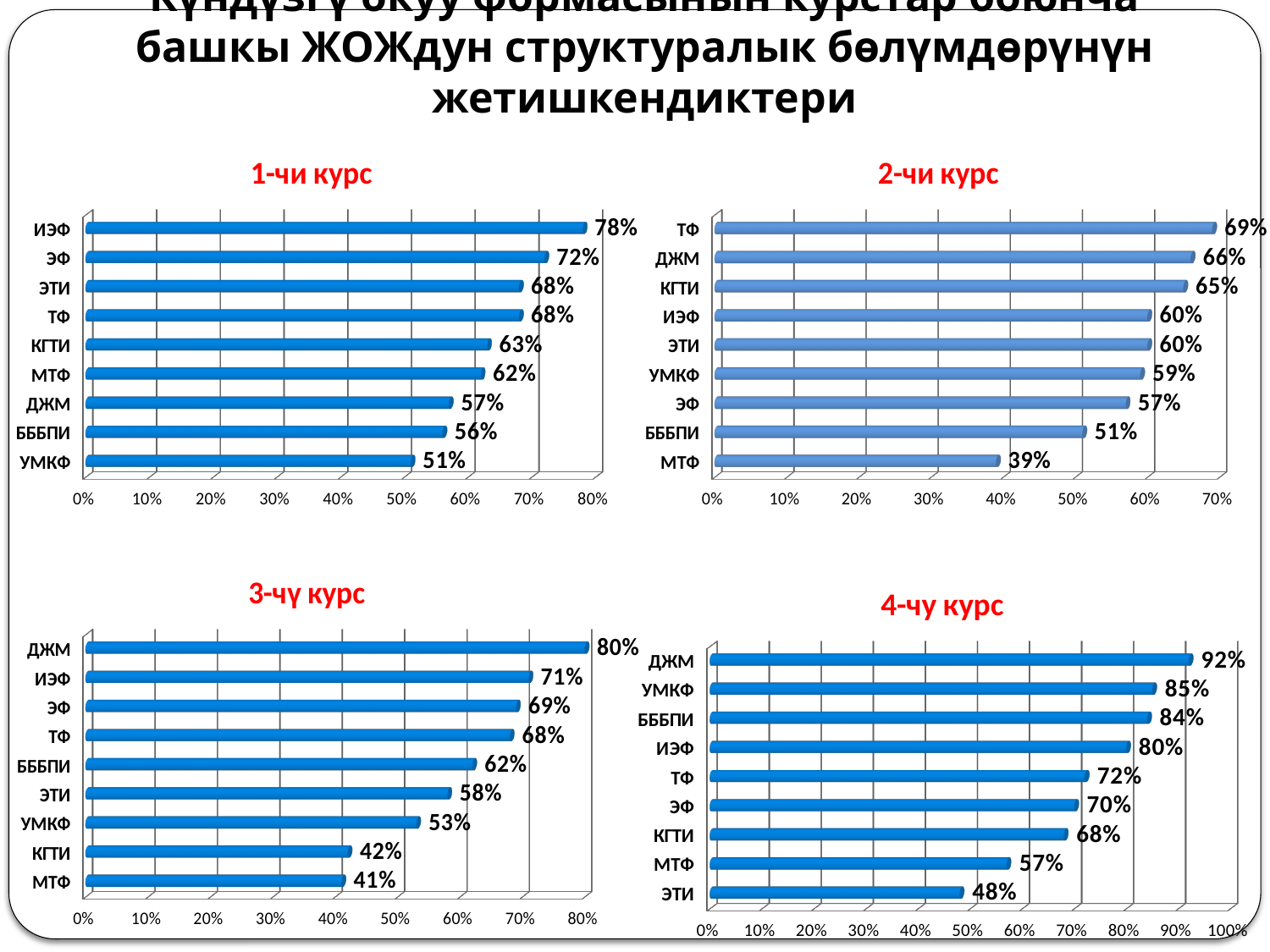
In the "3-чү курс" chart, which is larger, the value for ЭФ or the value for ЭТИ? ЭФ In the "4-чу курс" chart, what is the value for УМКФ? 85% In the "1-чи курс" chart, what is the value for ИЭФ? 78% In the "2-чи курс" chart, what is the difference between ТФ and МТФ? 30% What type of chart is the "1-чи курс" chart? Bar chart In the "3-чү курс" chart, what is the value for ДЖМ? 80% In the "2-чи курс" chart, which category has the highest value? ТФ In the "4-чу курс" chart, which category has the lowest value? ЭТИ In the "4-чу курс" chart, what is the difference between ДЖМ and ЭТИ? 44% In the "2-чи курс" chart, what is the value for МТФ? 39% In the "3-чү курс" chart, how many categories are shown? 9 In the "1-чи курс" chart, which category has the lowest value? УМКФ